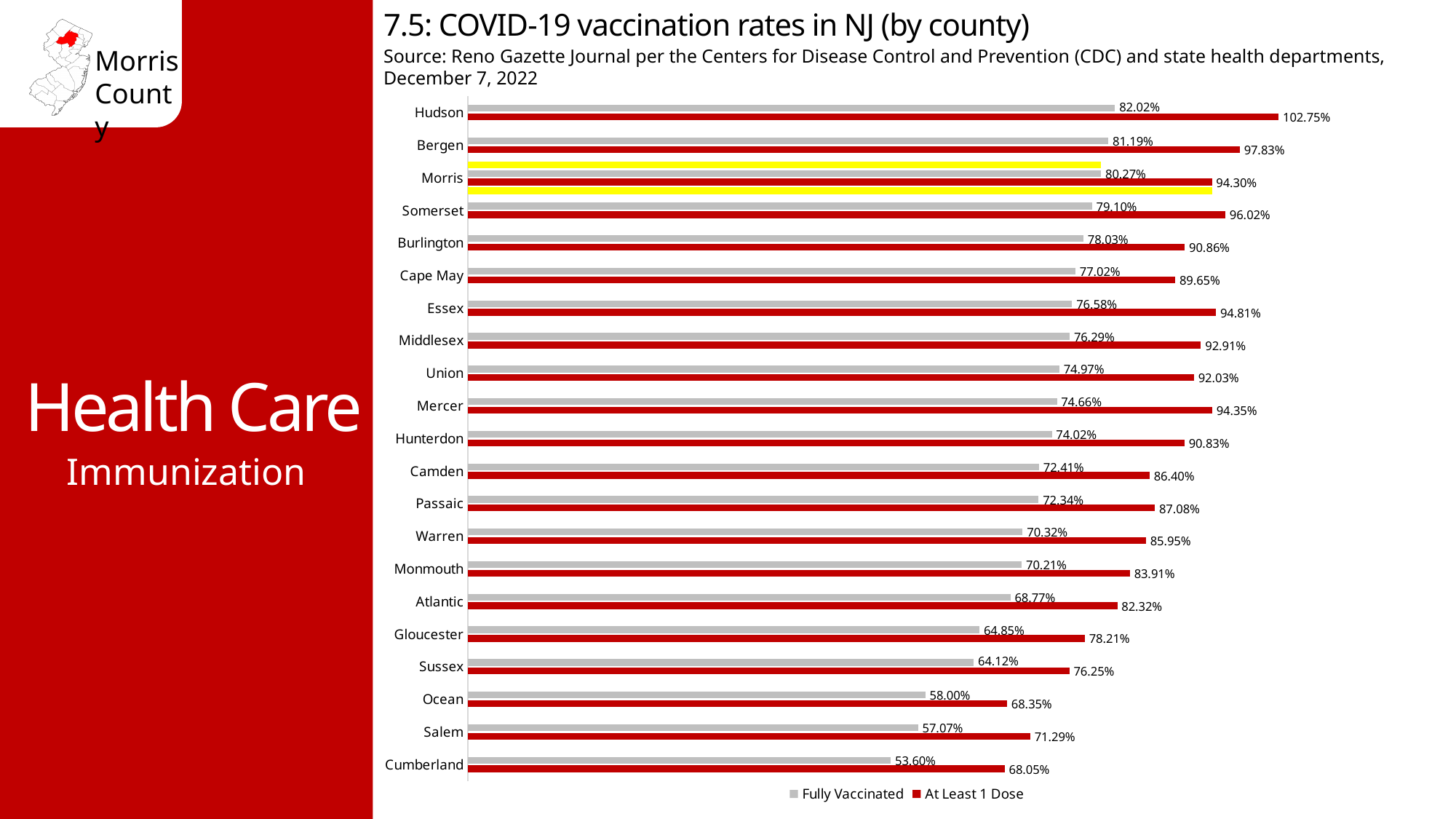
How many counties are shown in the chart? 21 What is the At Least 1 Dose rate for Hudson county? 102.75% Do the Fully Vaccinated rates rise or fall going from Hudson at the top to Cumberland at the bottom? Fall Which county has the lowest Fully Vaccinated rate? Cumberland How many series does the legend list? 2 What is the difference between the At Least 1 Dose rate and the Fully Vaccinated rate for Morris county? 14.03% What is the Fully Vaccinated rate for Morris county? 80.27% Which county has the larger At Least 1 Dose rate, Somerset or Essex? Somerset What is the At Least 1 Dose rate for Morris county? 94.30% Which county has the highest Fully Vaccinated rate? Hudson What kind of chart is shown on the slide? Bar chart Which county's bars are highlighted in yellow? Morris